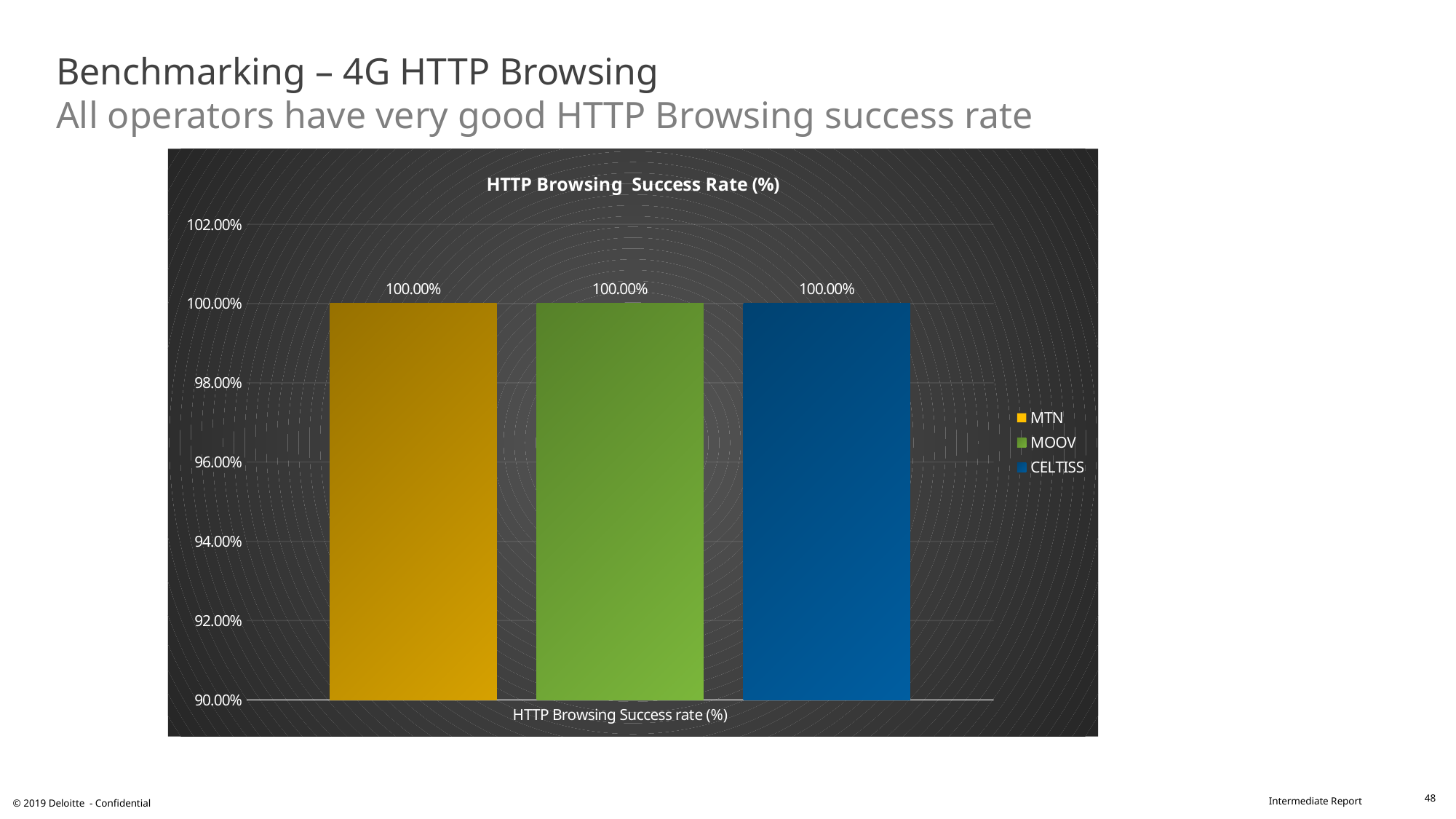
What is the HTTP Browsing Success Rate for MTN? 100.00% How many series does the legend list? 3 What is the HTTP Browsing Success Rate for CELTISS? 100.00% What is the HTTP Browsing Success Rate for MOOV? 100.00% Is the HTTP Browsing Success Rate for MOOV greater or less than 98.00%? greater What kind of chart is shown on the slide? Bar chart What is the difference between the HTTP Browsing Success Rate of MTN and CELTISS? 0.00% How many bars are plotted in the chart? 3 What is the title of the chart? HTTP Browsing Success Rate (%) Which operator is represented by the blue bar? CELTISS Is the HTTP Browsing Success Rate for CELTISS greater or less than 102.00%? less